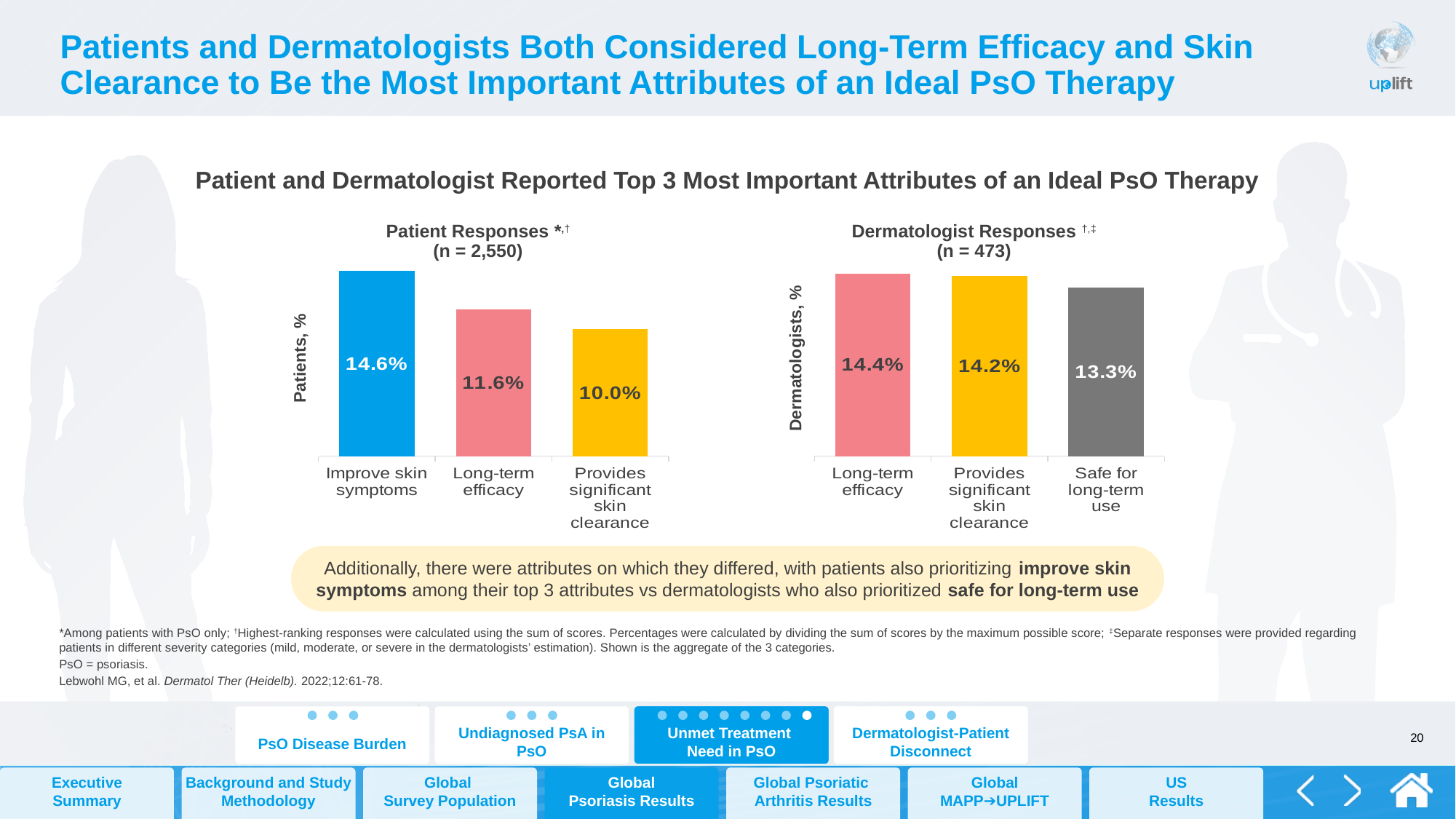
How many attributes are shown in the Patient Responses chart? 3 What is the sample size (n) shown for the Dermatologist Responses chart? 473 In the Dermatologist Responses chart, what is the difference between Provides significant skin clearance and Safe for long-term use? 0.9% In the Patient Responses chart, what is the value for Provides significant skin clearance? 10.0% In the Dermatologist Responses chart, what is the value for Long-term efficacy? 14.4% In the Patient Responses chart, what is the value for Improve skin symptoms? 14.6% In the Patient Responses chart, what is the difference between Improve skin symptoms and Long-term efficacy? 3.0% What type of chart is the Dermatologist Responses chart? Bar chart Which is larger: Long-term efficacy in the Patient Responses chart or Long-term efficacy in the Dermatologist Responses chart? Dermatologist Responses In the Dermatologist Responses chart, which attribute has the lowest value? Safe for long-term use In the Dermatologist Responses chart, what is the value for Safe for long-term use? 13.3% In the Patient Responses chart, which attribute has the highest value? Improve skin symptoms